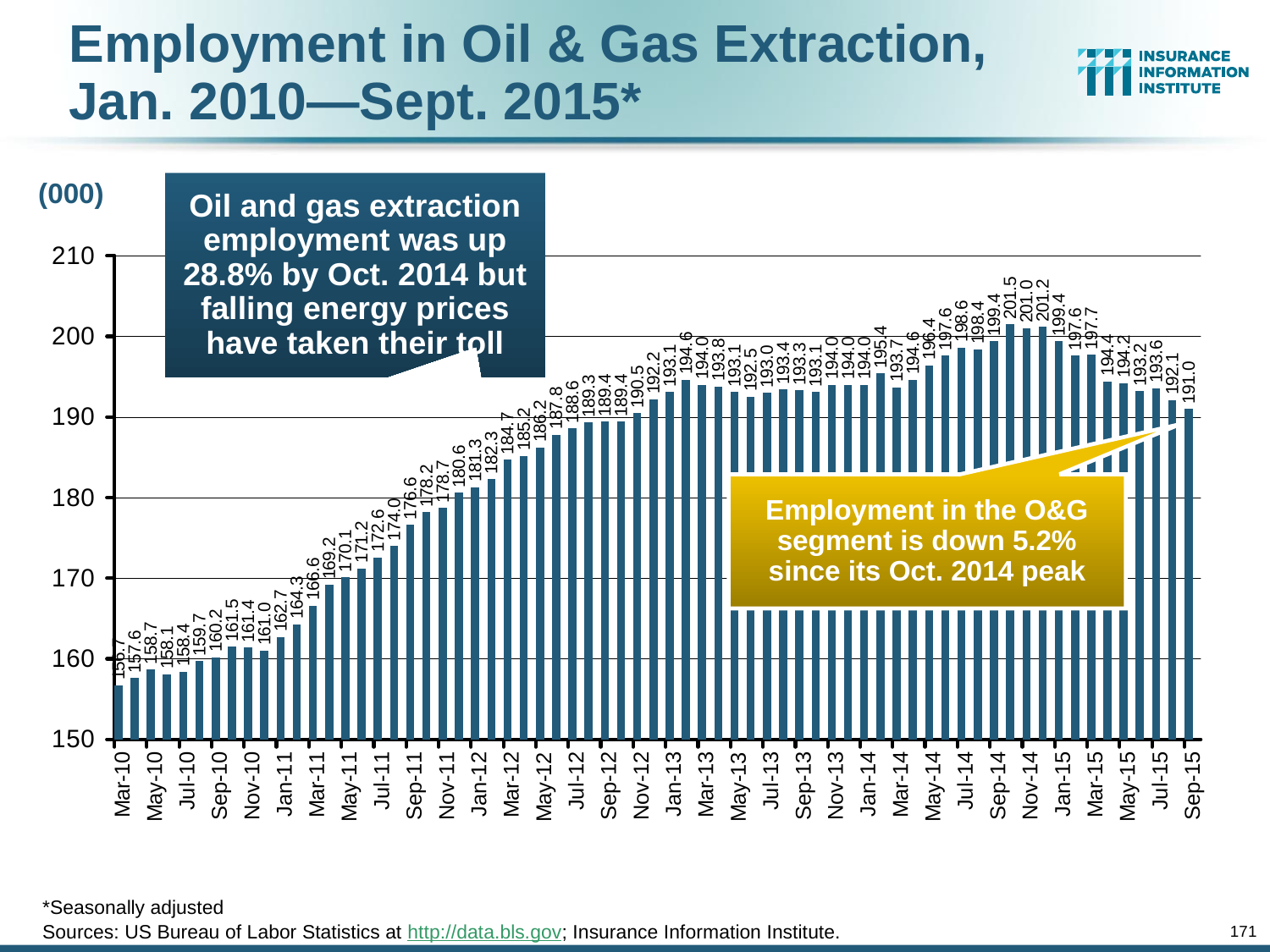
What type of chart is shown on the slide? Bar chart Which is larger, the value for Jan-12 or the value for Jan-14? Jan-14 What is the difference between the Sep-15 value and the Mar-10 value? 34.3 What is the highest employment value shown on the chart? 201.5 Does employment generally rise or fall from Mar-10 to Oct-14? Rise According to the callout box, by what percentage is O&G employment down since its Oct. 2014 peak? 5.2% What is the employment value (000) for Sep-15? 191.0 What is the employment value (000) for Jul-11? 172.6 Which month has the lowest employment value on the chart? Mar-10 What is the employment value (000) for Jan-15? 199.4 What is the employment value (000) for Mar-10? 156.7 Is the value for Sep-12 greater or less than 190? less